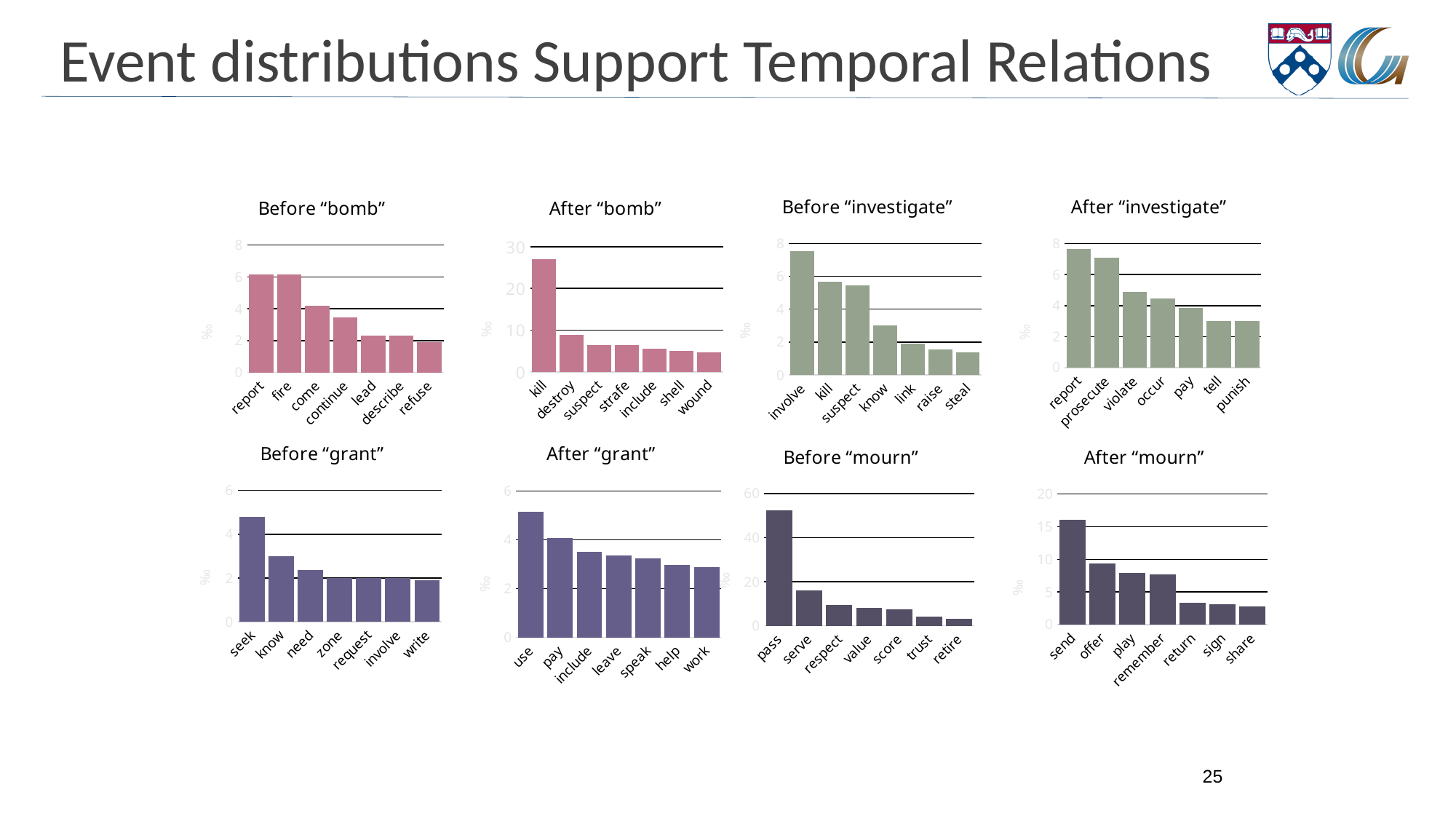
In the After "bomb" chart, is the value for kill greater or less than 20? greater In the After "mourn" chart, which is larger, the value for send or the value for offer? send In the Before "investigate" chart, is the value for know greater or less than 4? less In the Before "investigate" chart, which category has the highest value? involve What kind of chart is the After "investigate" chart? bar chart In the Before "mourn" chart, is the value for pass greater or less than 40? greater In the After "grant" chart, which category has the highest value? use In the Before "grant" chart, which category has the highest value? seek How many categories are shown in the Before "bomb" chart? 7